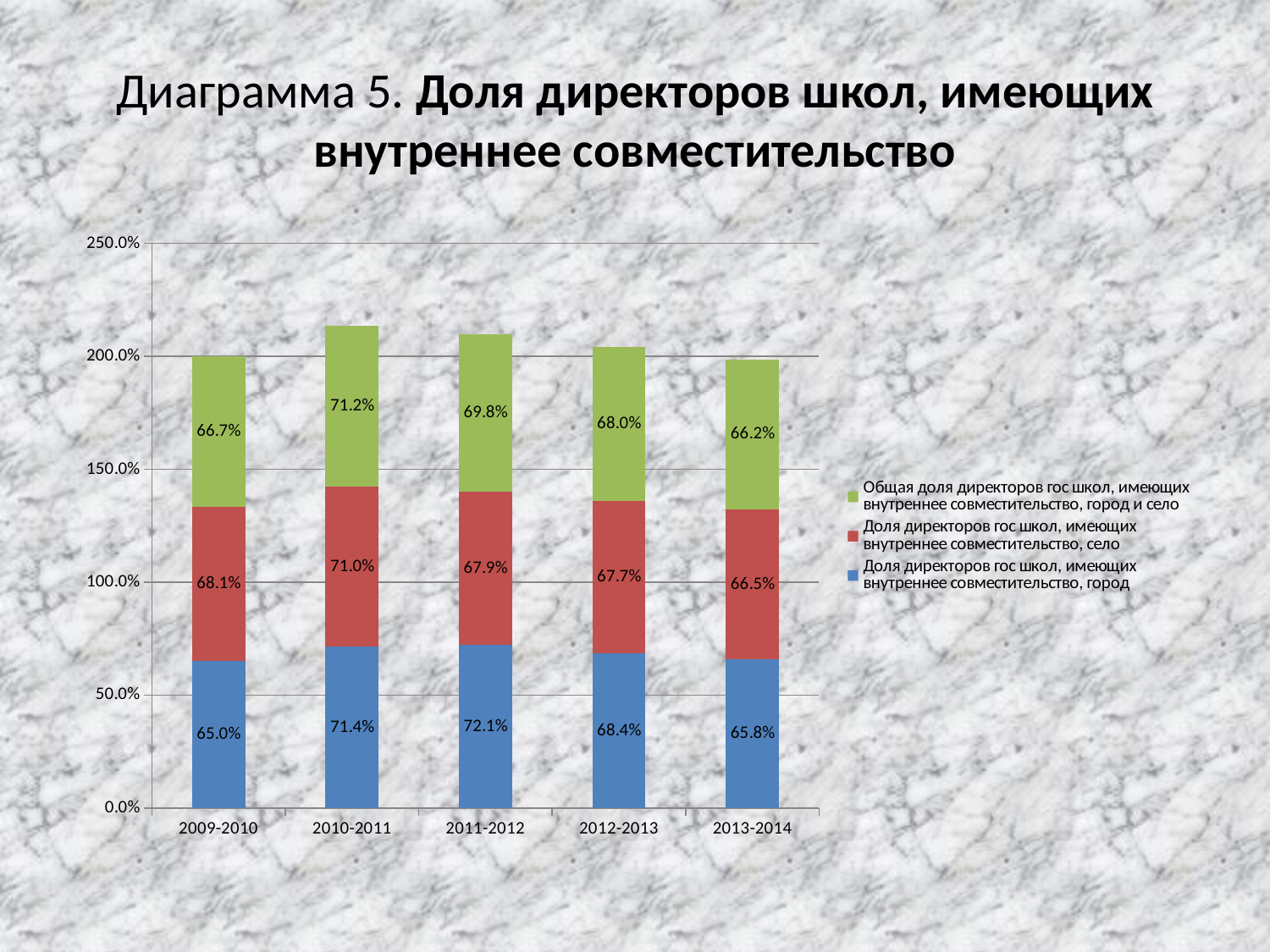
How many school-year categories are shown on the x axis? 5 What is the value for 'Доля директоров гос школ, имеющих внутреннее совместительство, село' in 2009-2010? 68.1% How many series does the legend list? 3 Is the total height of the stacked bar for 2013-2014 greater or less than 200.0%? less Which is larger: the 'село' value in 2010-2011 or the 'село' value in 2013-2014? 2010-2011 What is the value for 'Общая доля директоров гос школ, имеющих внутреннее совместительство, город и село' in 2013-2014? 66.2% What type of chart is shown on the slide? stacked bar chart What is the value for 'Доля директоров гос школ, имеющих внутреннее совместительство, город' in 2011-2012? 72.1% In which school year is the value for 'Общая доля директоров гос школ, имеющих внутреннее совместительство, город и село' lowest? 2013-2014 What is the total of the stacked bar for 2010-2011? 213.6% In which school year is the value for 'Доля директоров гос школ, имеющих внутреннее совместительство, город' highest? 2011-2012 What is the difference between the 'город' values for 2011-2012 and 2009-2010? 7.1%